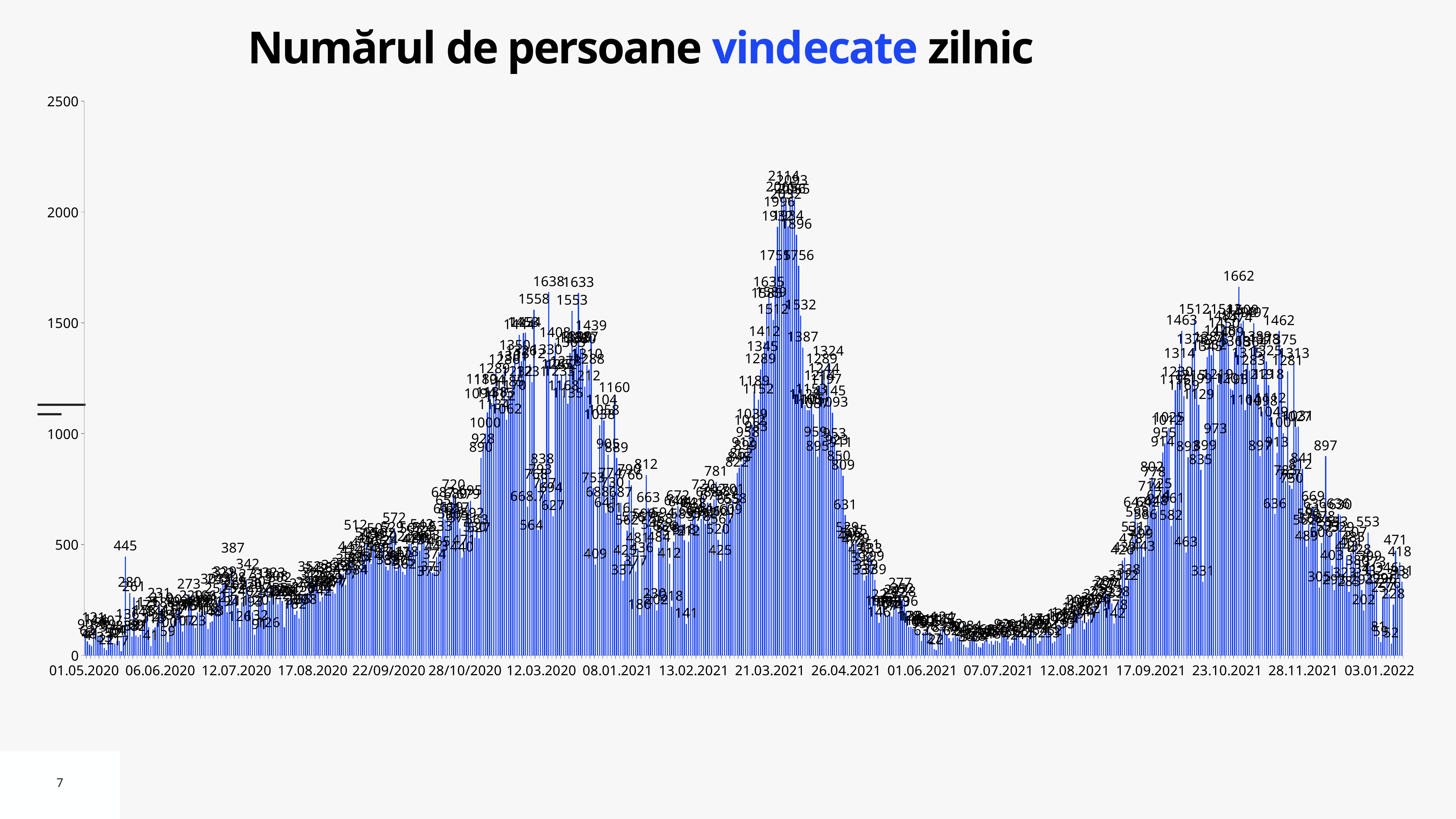
What kind of chart is shown on the slide? bar chart What is the difference between the March 2021 peak (2114) and the autumn 2021 peak (1662)? 452 What is the value of the tallest bar in the autumn 2021 wave (between 23.10.2021 and 28.11.2021)? 1662 What is the maximum value shown on the vertical axis? 2500 What is the value of the tallest bar between 01.05.2020 and 06.06.2020? 445 Which is larger: the peak value in March 2021 (2114) or the peak value in autumn 2021 (1662)? 2114 (March 2021) Do the values generally rise or fall between 26.04.2021 and 01.06.2021? fall What is the title of the chart? Numărul de persoane vindecate zilnic What is the highest daily value labeled on the chart? 2114 Is the value of the first bar, at 01.05.2020, greater or less than 500? less Do the values generally rise or fall between 17.09.2021 and 23.10.2021? rise Is the highest bar on the chart greater or less than 2000? greater